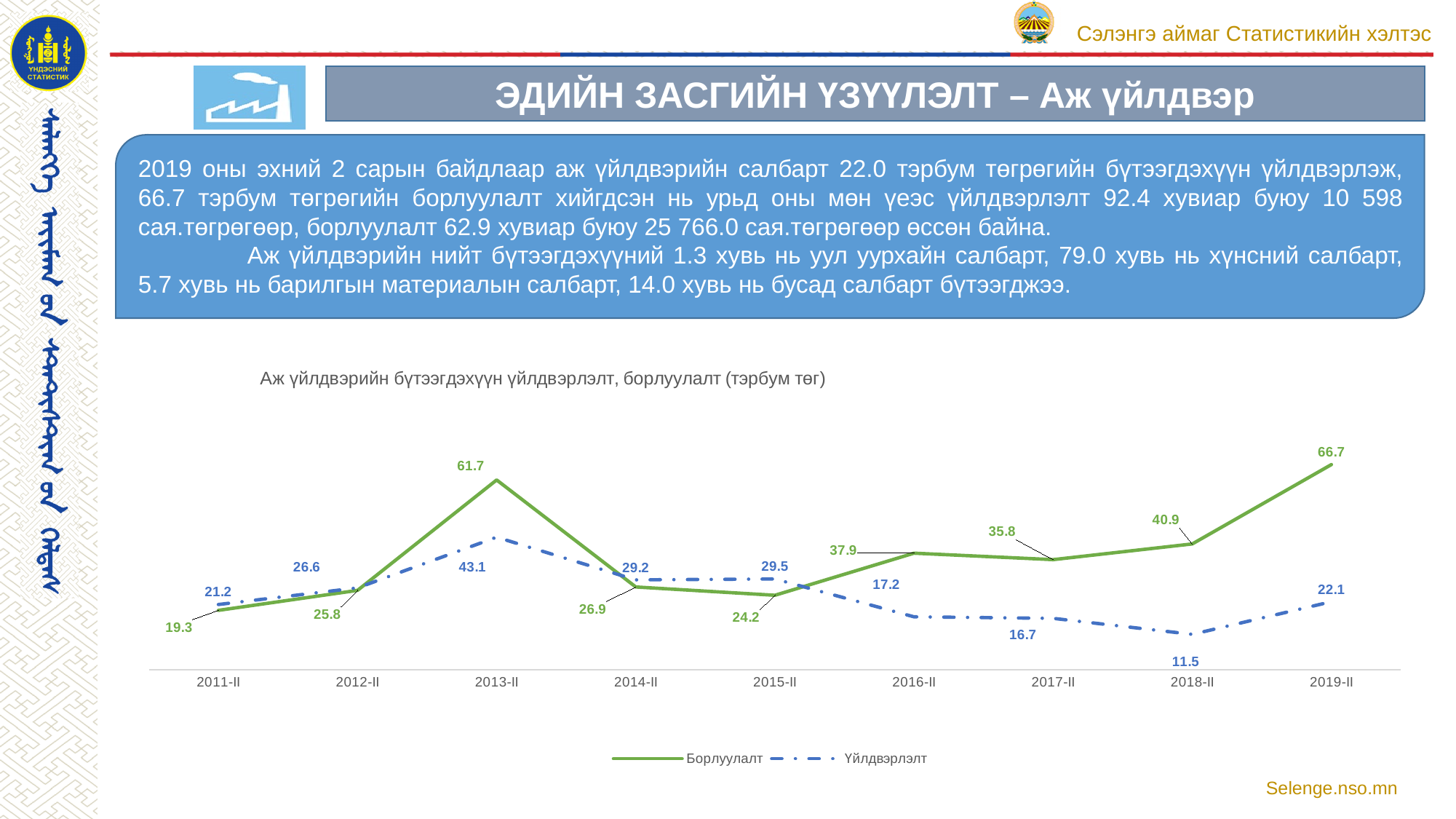
In which period is Борлуулалт the highest? 2019-II Which is larger in 2016-II, Борлуулалт or Үйлдвэрлэлт? Борлуулалт What type of chart is shown on the slide? Line chart What is the value of Үйлдвэрлэлт for 2018-II? 11.5 How many periods are shown on the x axis? 9 In which period is Үйлдвэрлэлт the highest? 2013-II How many series does the legend list? 2 What is the value of Үйлдвэрлэлт for 2013-II? 43.1 In which period is Үйлдвэрлэлт the lowest? 2018-II What is the value of Борлуулалт for 2019-II? 66.7 What is the value of Борлуулалт for 2015-II? 24.2 What is the difference between Борлуулалт and Үйлдвэрлэлт in 2019-II? 44.6